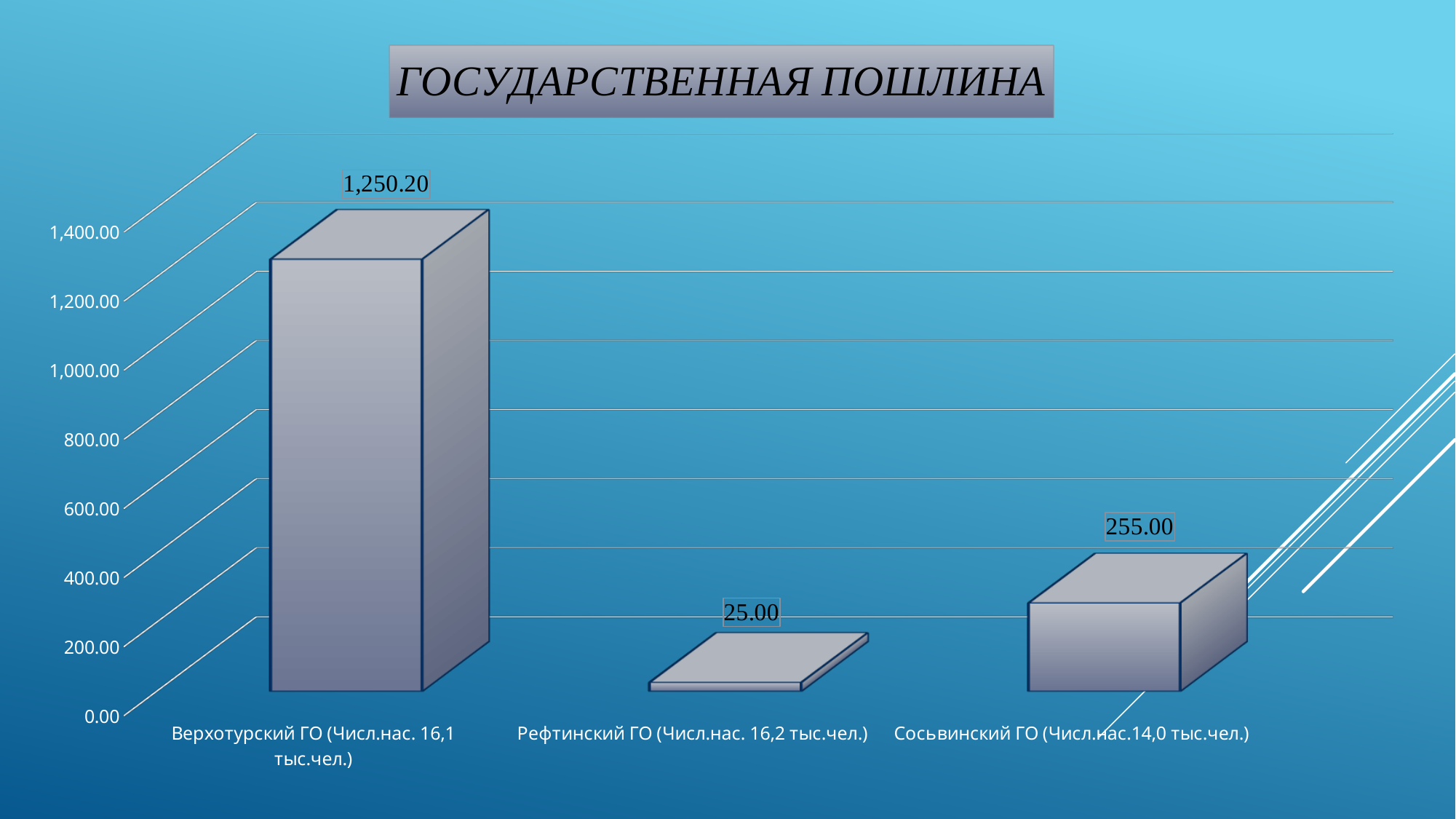
What is the title of the chart? ГОСУДАРСТВЕННАЯ ПОШЛИНА How many categories are shown on the chart? 3 What is the value for Верхотурский ГО? 1,250.20 Which category has the lowest value? Рефтинский ГО Which category has the highest value? Верхотурский ГО What is the value for Рефтинский ГО? 25.00 What is the value for Сосьвинский ГО? 255.00 What kind of chart is shown on the slide? bar chart Which is larger, the value for Сосьвинский ГО or the value for Рефтинский ГО? Сосьвинский ГО What is the difference between the values for Верхотурский ГО and Сосьвинский ГО? 995.20 What is the difference between the values for Сосьвинский ГО and Рефтинский ГО? 230.00 Is the value for Верхотурский ГО greater or less than 1,000.00? greater